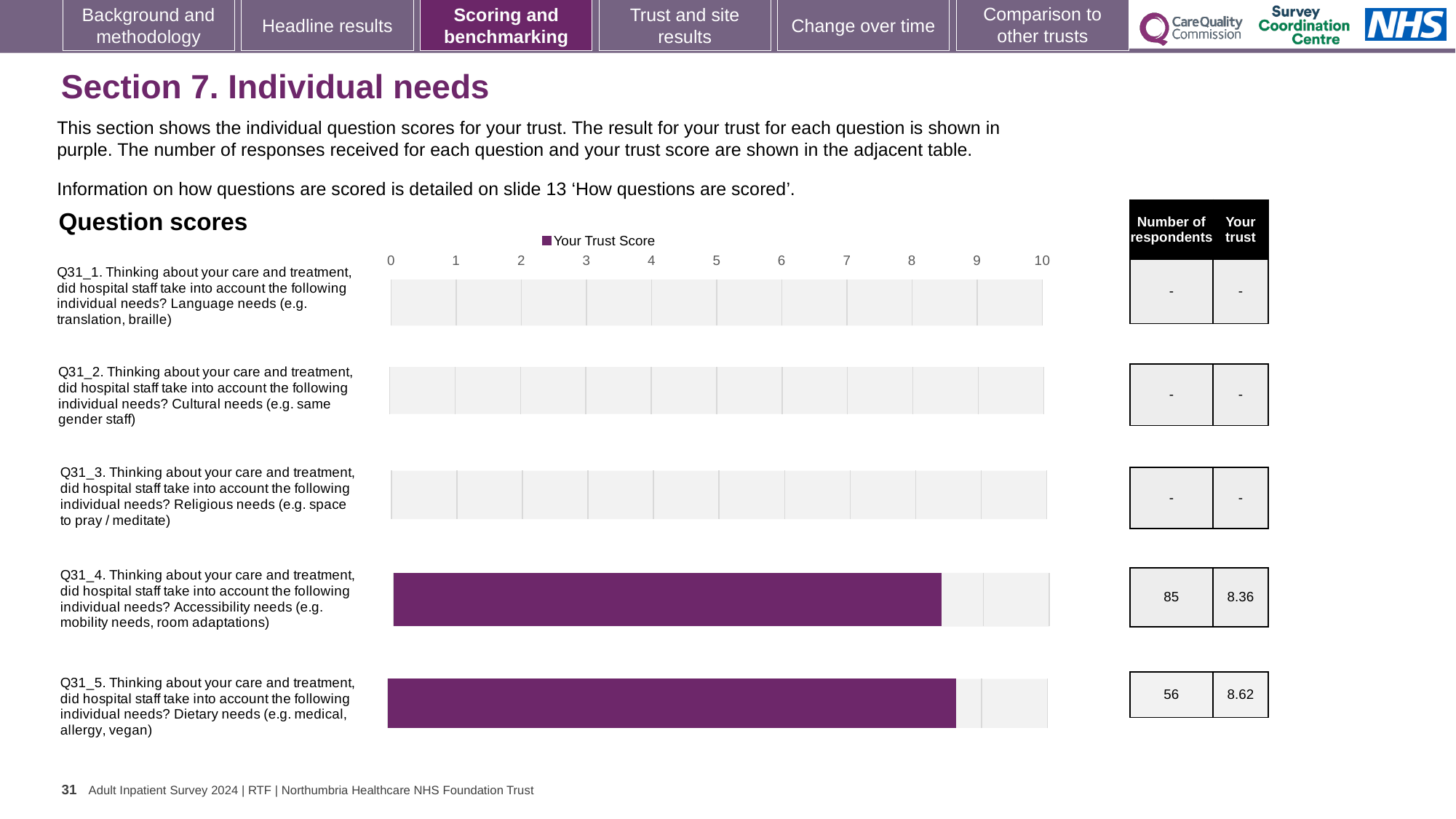
Which question has the higher trust score, Q31_4 or Q31_5? Q31_5 How many respondents answered Q31_5 (dietary needs)? 56 What is the series name shown in the chart legend? Your Trust Score How many of the five questions have a trust score shown as a bar? 2 Is the trust score for Q31_4 greater or less than 8? greater What is the difference between the trust scores for Q31_5 and Q31_4? 0.26 What is the trust score for Q31_5 (dietary needs)? 8.62 Is the trust score for Q31_5 greater or less than 9? less What is the trust score for Q31_4 (accessibility needs)? 8.36 What type of chart is used to show the question scores? Bar chart How many respondents answered Q31_4 (accessibility needs)? 85 How many questions are listed in the Question scores chart? 5